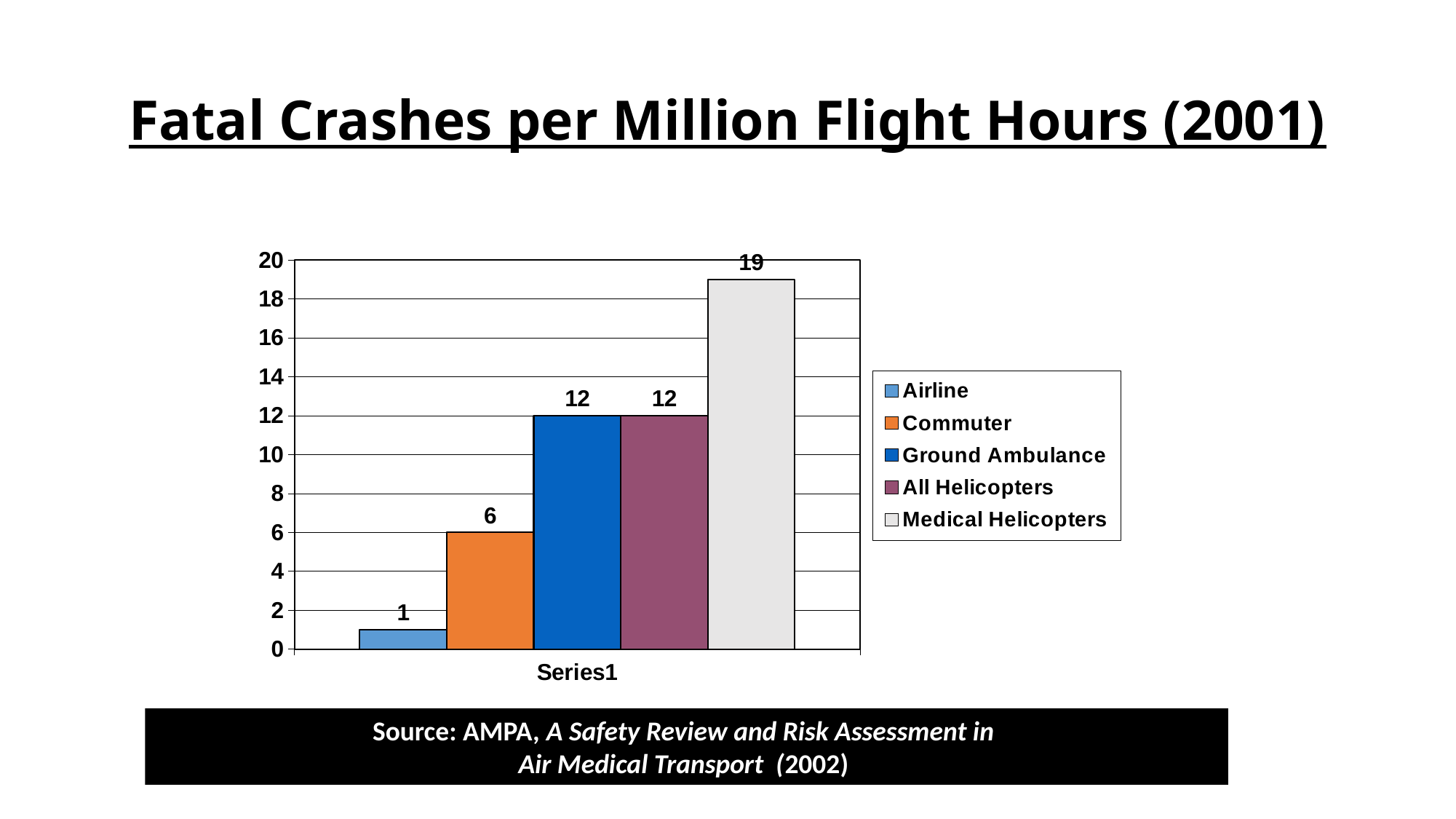
What is the value for Medical Helicopters? 19 Which category has the highest value? Medical Helicopters Which category has the lowest value? Airline What is the value for Commuter? 6 What is the value for Ground Ambulance? 12 What is the value for Airline? 1 What is the title of the chart? Fatal Crashes per Million Flight Hours (2001) Which is larger, the value for Commuter or the value for Ground Ambulance? Ground Ambulance What is the difference between the values for Medical Helicopters and All Helicopters? 7 What is the difference between the values for Commuter and Airline? 5 What kind of chart is shown on the slide? Bar chart How many series does the legend list? 5